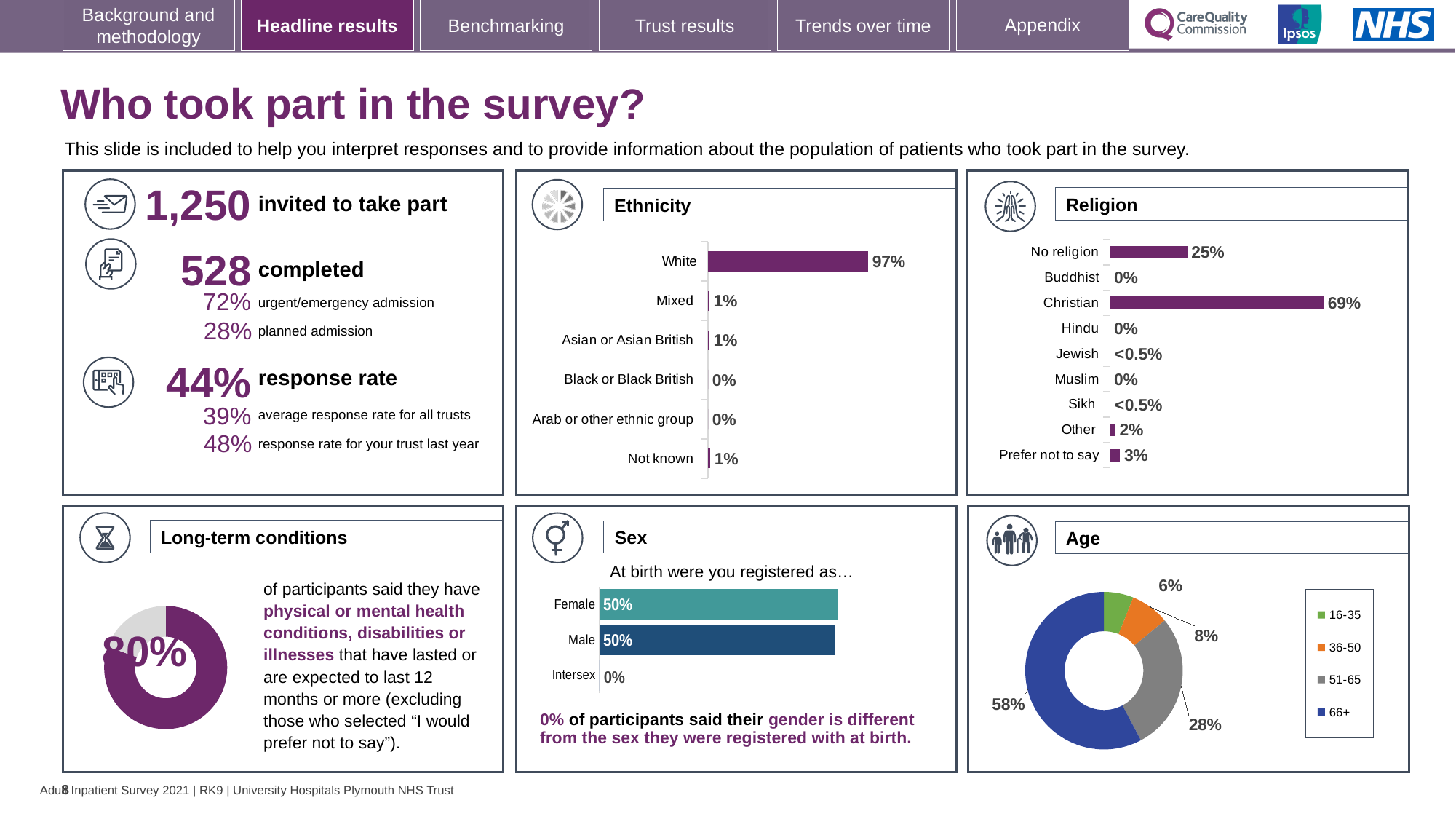
In the Sex chart, what percentage of participants were registered as Female at birth? 50% In the Religion chart, what percentage of participants were Christian? 69% In the Ethnicity chart, how many ethnicity categories are listed? 6 In the Ethnicity chart, which category has the highest value? White In the Religion chart, what is the difference between the Christian and No religion values? 44% What kind of chart is the Sex chart? Bar chart In the Age chart, which age group has the smallest share? 16-35 In the Age chart, what share of participants were aged 66+? 58% In the Religion chart, which is larger, Other or Prefer not to say? Prefer not to say In the Religion chart, what is the value for Prefer not to say? 3% In the Ethnicity chart, what percentage of participants were White? 97% In the Age chart, how many age groups does the legend list? 4